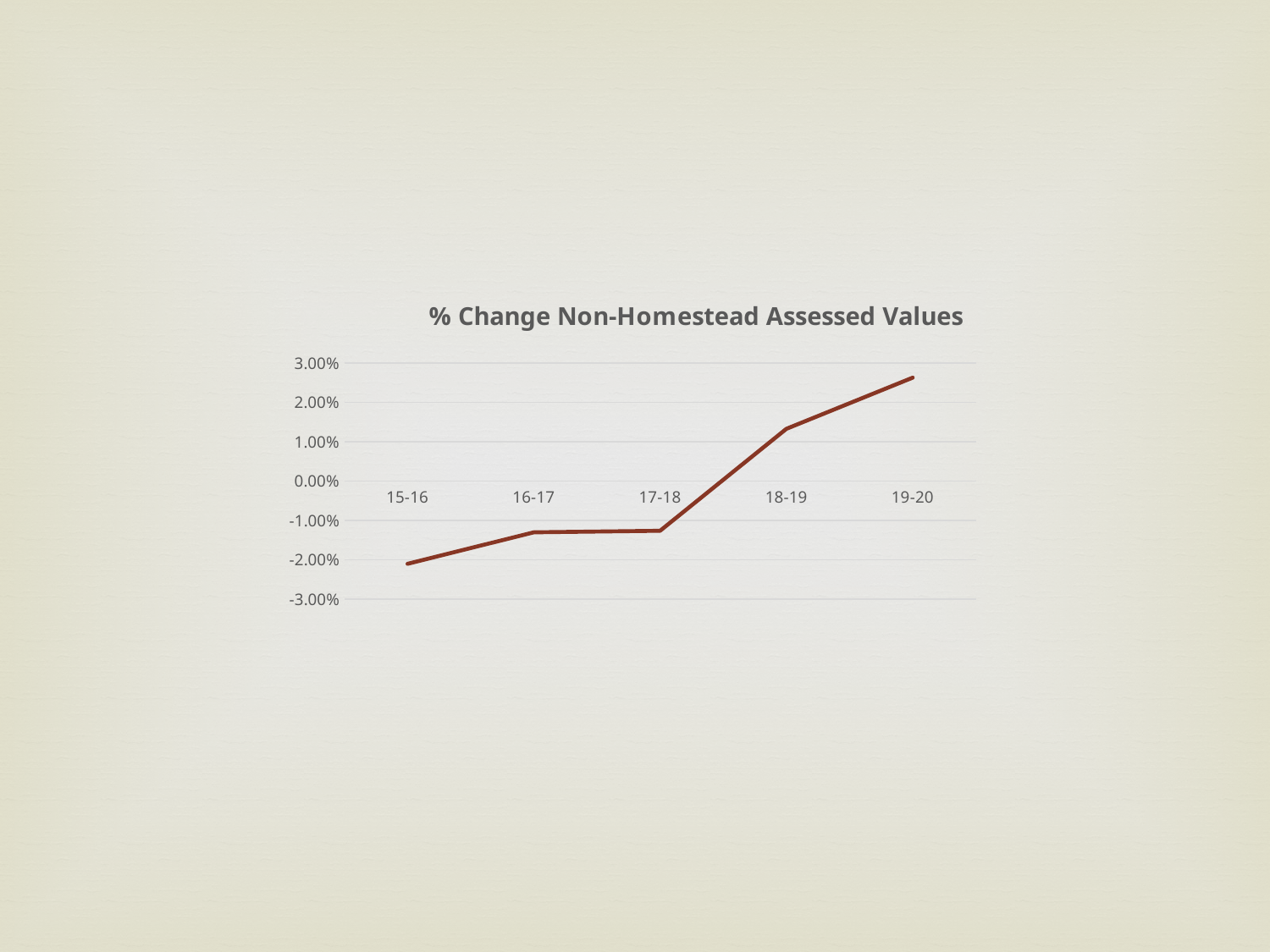
Is the value for 19-20 greater or less than 2.00%? greater What kind of chart is shown on the slide? line chart Do the values generally rise or fall from 15-16 to 19-20? rise How many points are plotted on the line? 5 What is the title of the chart? % Change Non-Homestead Assessed Values Is the value for 18-19 greater or less than 1.00%? greater Which is larger, the value for 16-17 or the value for 15-16? 16-17 Which year has the lowest % change in non-homestead assessed values? 15-16 Which year has the highest % change in non-homestead assessed values? 19-20 Is the value for 17-18 greater or less than 0.00%? less Which is larger, the value for 18-19 or the value for 17-18? 18-19